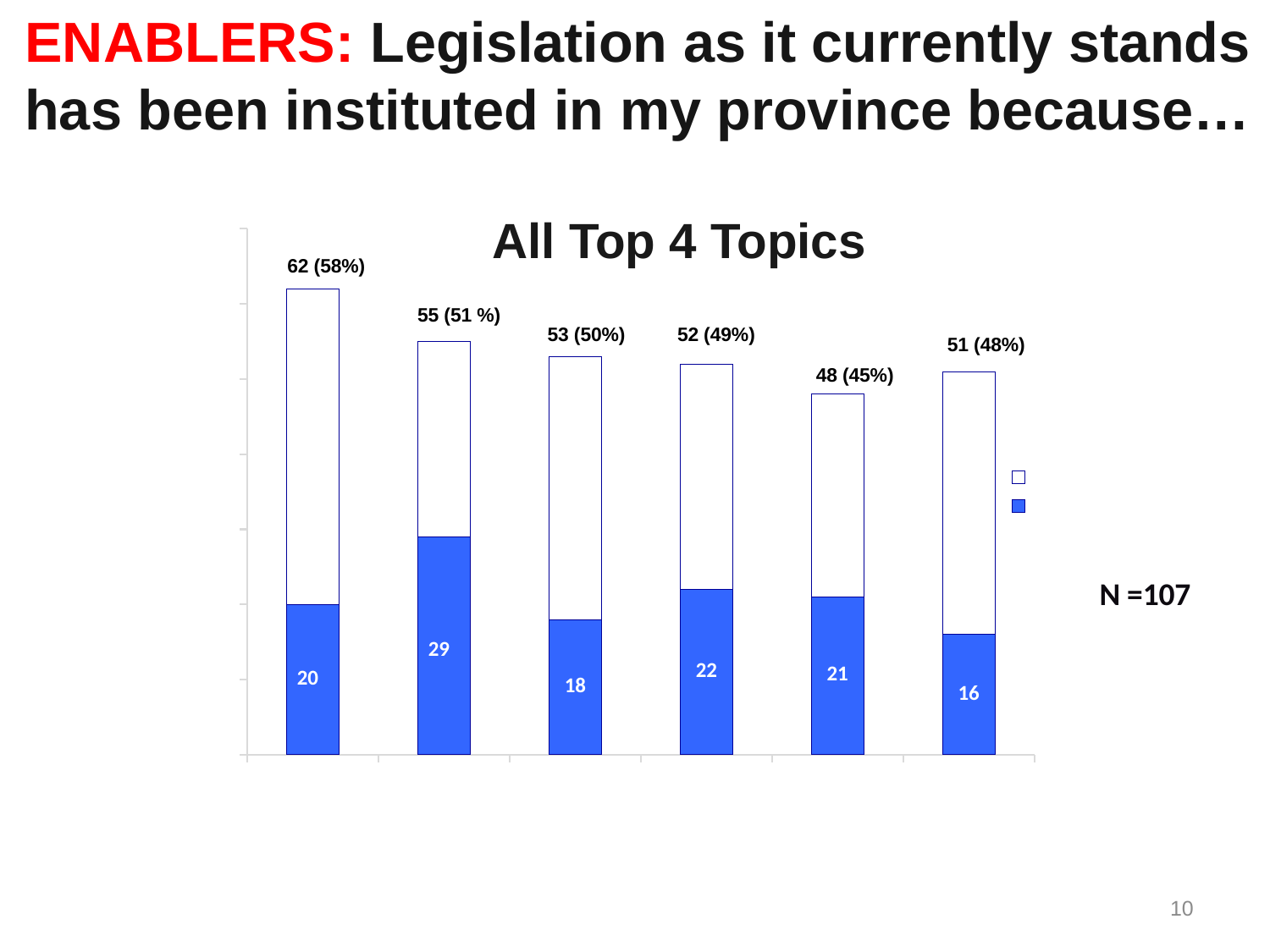
What is the total label printed above the first (leftmost) bar? 62 (58%) Is the blue segment of the second bar (29) larger or smaller than the blue segment of the third bar (18)? larger What value is printed in the blue segment of the second bar from the left? 29 How many series does the legend list? 2 What is the total label printed above the fifth bar from the left? 48 (45%) What is the difference between the total of the first bar (62) and the total of the fifth bar (48)? 14 Which bar has the highest total? the first (leftmost) bar, 62 (58%) What value is printed in the blue segment of the rightmost bar? 16 What type of chart is shown on the slide? bar chart What is the title of the chart? All Top 4 Topics How many bars are plotted in the chart? 6 Which bar has the smallest blue segment? the rightmost bar, 16